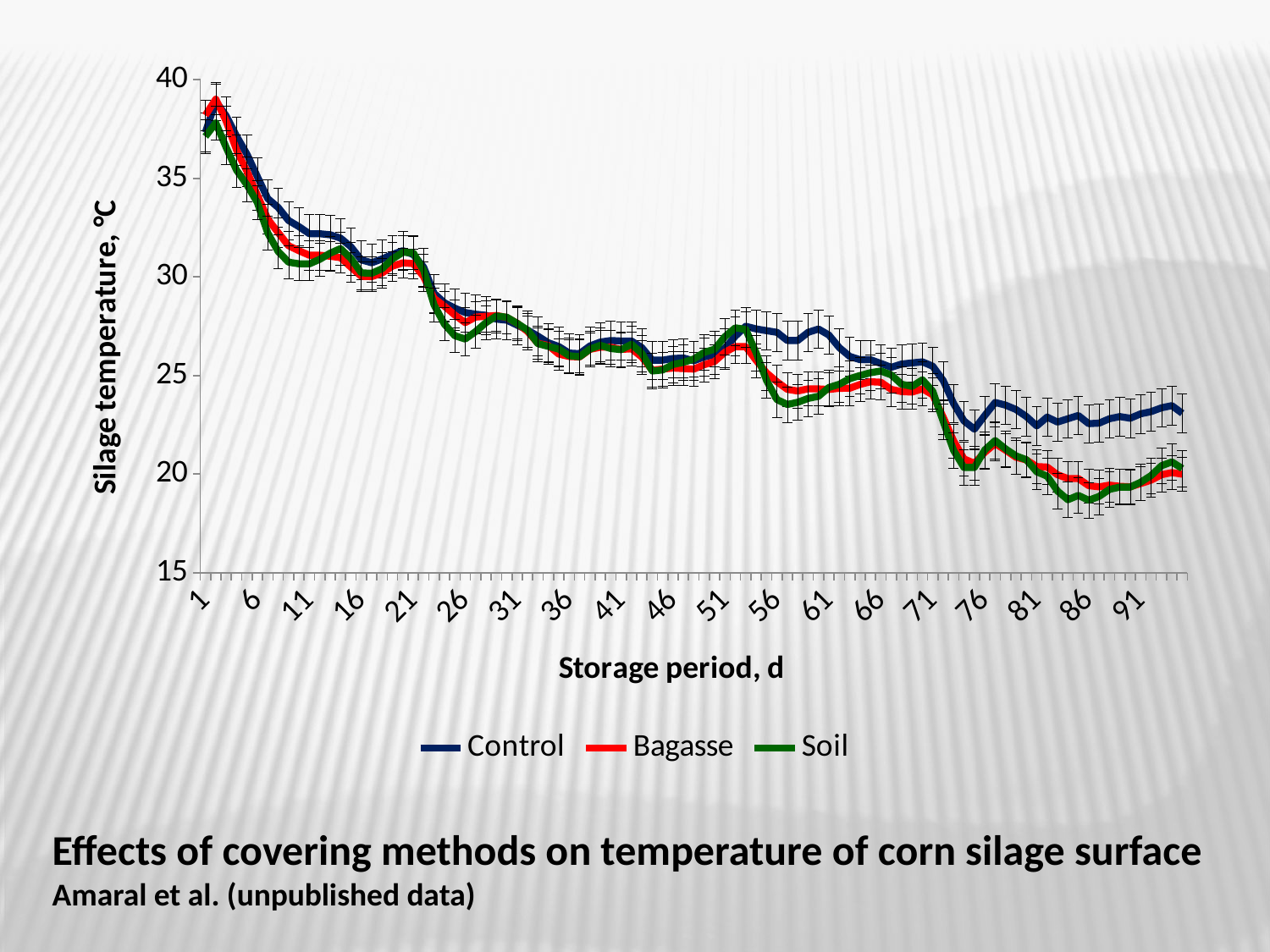
What kind of chart is shown on the slide? line chart What is the title of the y axis? Silage temperature, °C At day 91, which series has the higher temperature, Control or Soil? Control Is the Control temperature at day 1 greater or less than 35? greater Is the Control temperature at day 91 greater or less than 20? greater Do the silage temperature values generally rise or fall as the storage period increases? fall Is the Control temperature at day 61 greater or less than 25? greater How many series does the legend list? 3 Which series has the highest temperature at the end of the storage period? Control What are the series names listed in the legend? Control, Bagasse, Soil